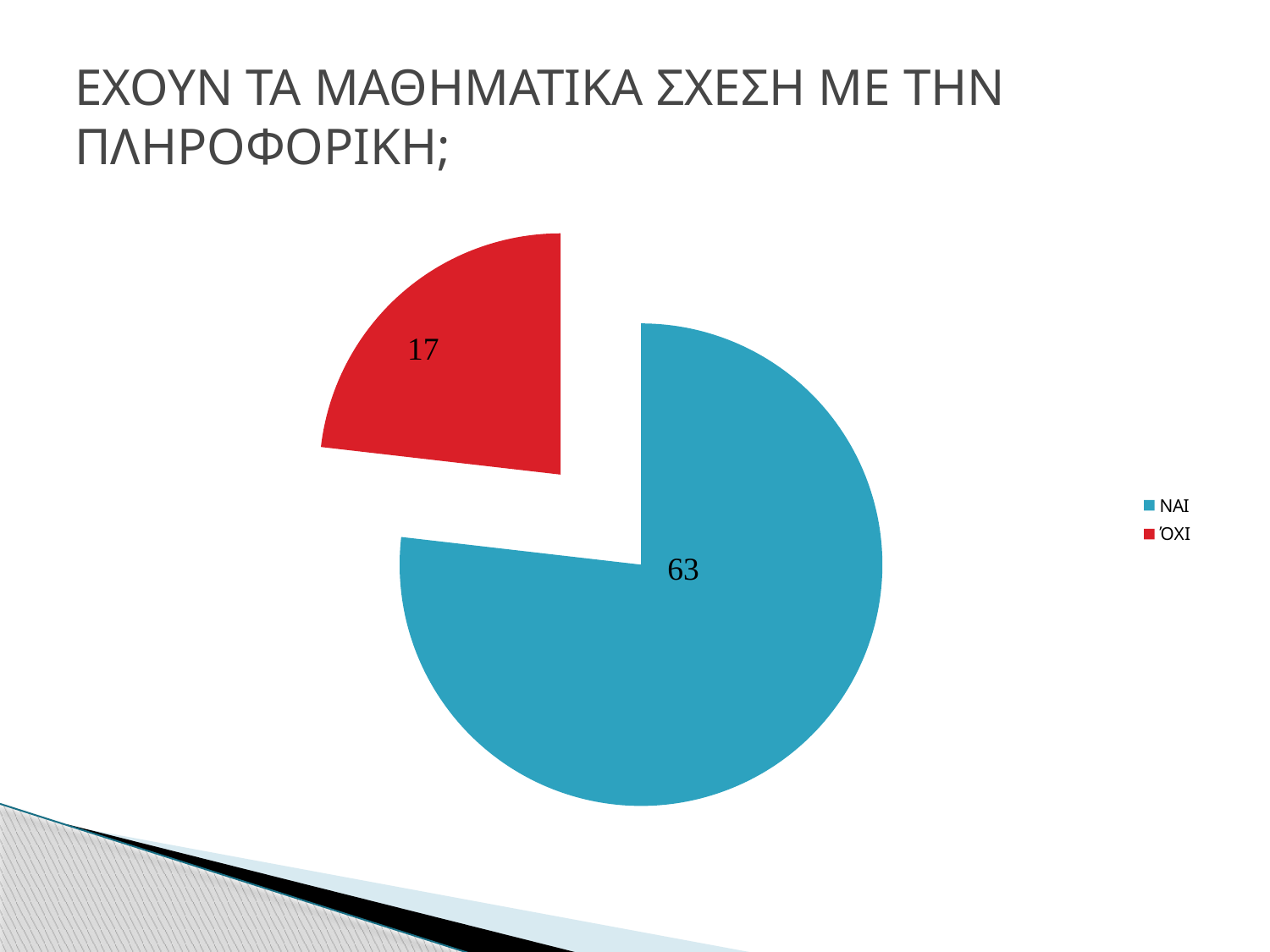
What is the total of all slices in the pie chart? 80 What colour is the ΌΧΙ slice in the pie chart? Red How many entries does the legend list? 2 What is the value for ΝΑΙ in the pie chart? 63 Which slice of the pie chart is the smallest? ΌΧΙ What type of chart is shown on the slide? Pie chart What is the value for ΌΧΙ in the pie chart? 17 What is the difference between the values for ΝΑΙ and ΌΧΙ? 46 What share of the pie does the ΝΑΙ slice represent? 78.75% How many slices does the pie chart have? 2 Which is larger, the value for ΝΑΙ or the value for ΌΧΙ? ΝΑΙ Which slice of the pie chart is the largest? ΝΑΙ